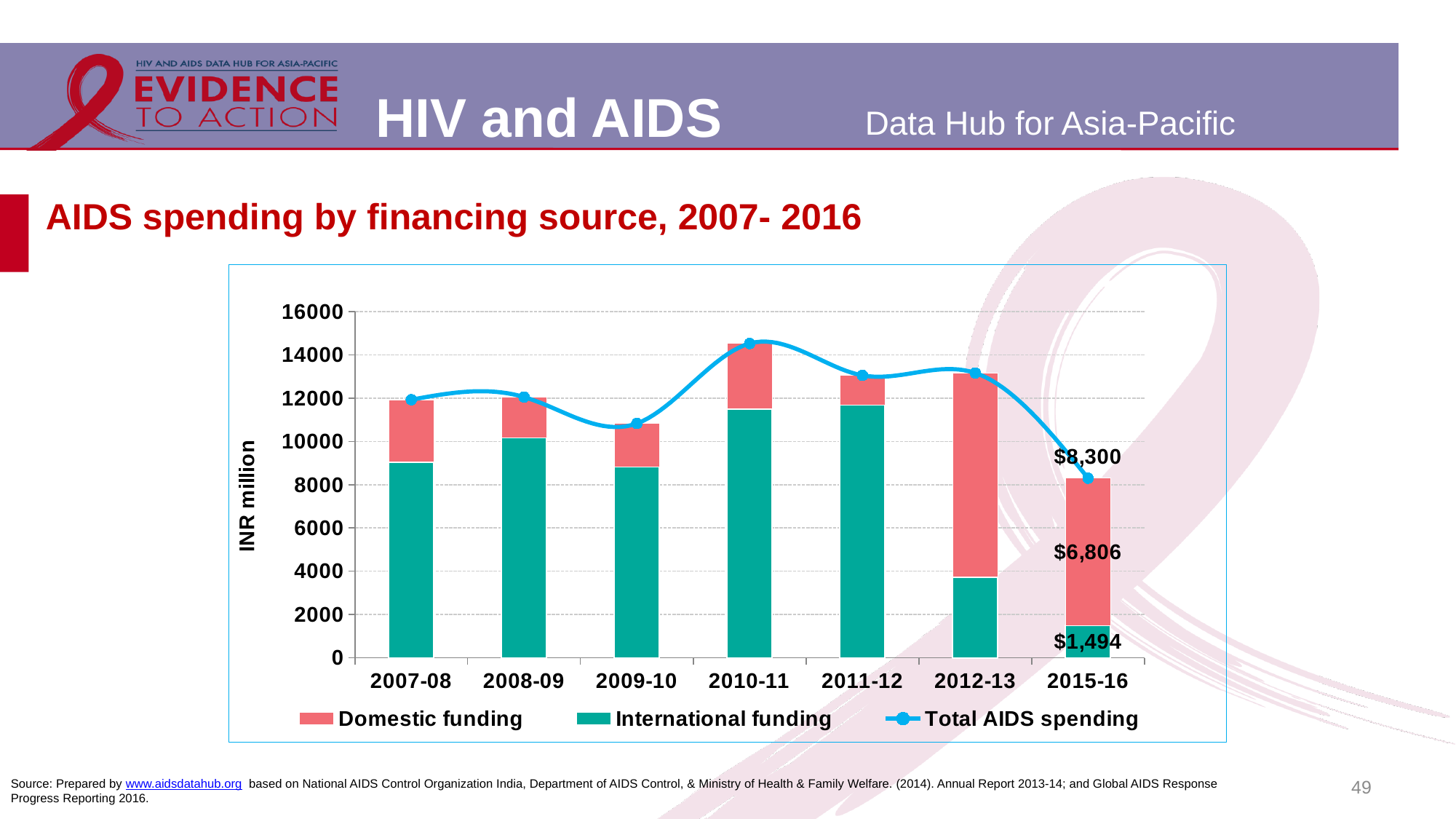
How much larger is domestic funding than international funding in 2015-16? $5,312 How many series does the legend list? 3 What is the international funding value for 2015-16? $1,494 What is the domestic funding value for 2015-16? $6,806 What kind of chart is this? Bar chart (stacked) with a line Which period has more international funding, 2011-12 or 2012-13? 2011-12 Is the international funding for 2009-10 greater or less than 10000? less In which period is total AIDS spending lowest? 2015-16 What is the total AIDS spending for 2015-16? $8,300 How many time periods are shown on the x axis? 7 In which period is total AIDS spending highest? 2010-11 What is the label on the y axis? INR million